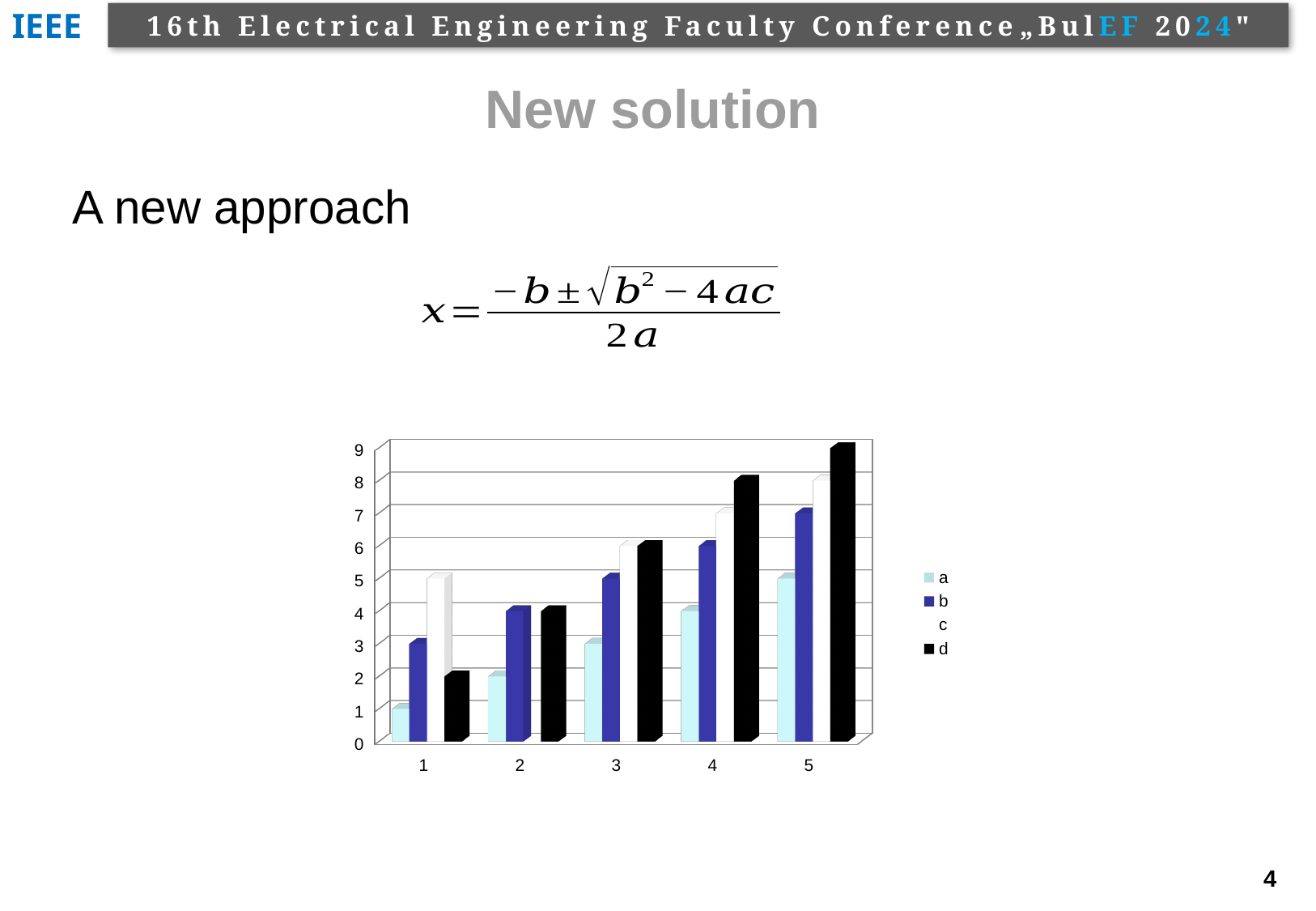
Do the values of series d rise or fall from category 1 to category 5? rise What are the series names listed in the legend? a, b, c, d How many series does the legend list? 4 Is the value for series d at category 5 greater or less than 8? greater What kind of chart is shown on the slide? bar chart Which category has the highest value for series d? 5 Which category has the lowest value for series a? 1 Do the values of series a rise or fall from category 1 to category 5? rise Is the value for series a at category 3 greater or less than 4? less Which series is drawn in black? d How many categories are shown on the x axis? 5 At category 1, which is larger, the value for series b or the value for series d? b